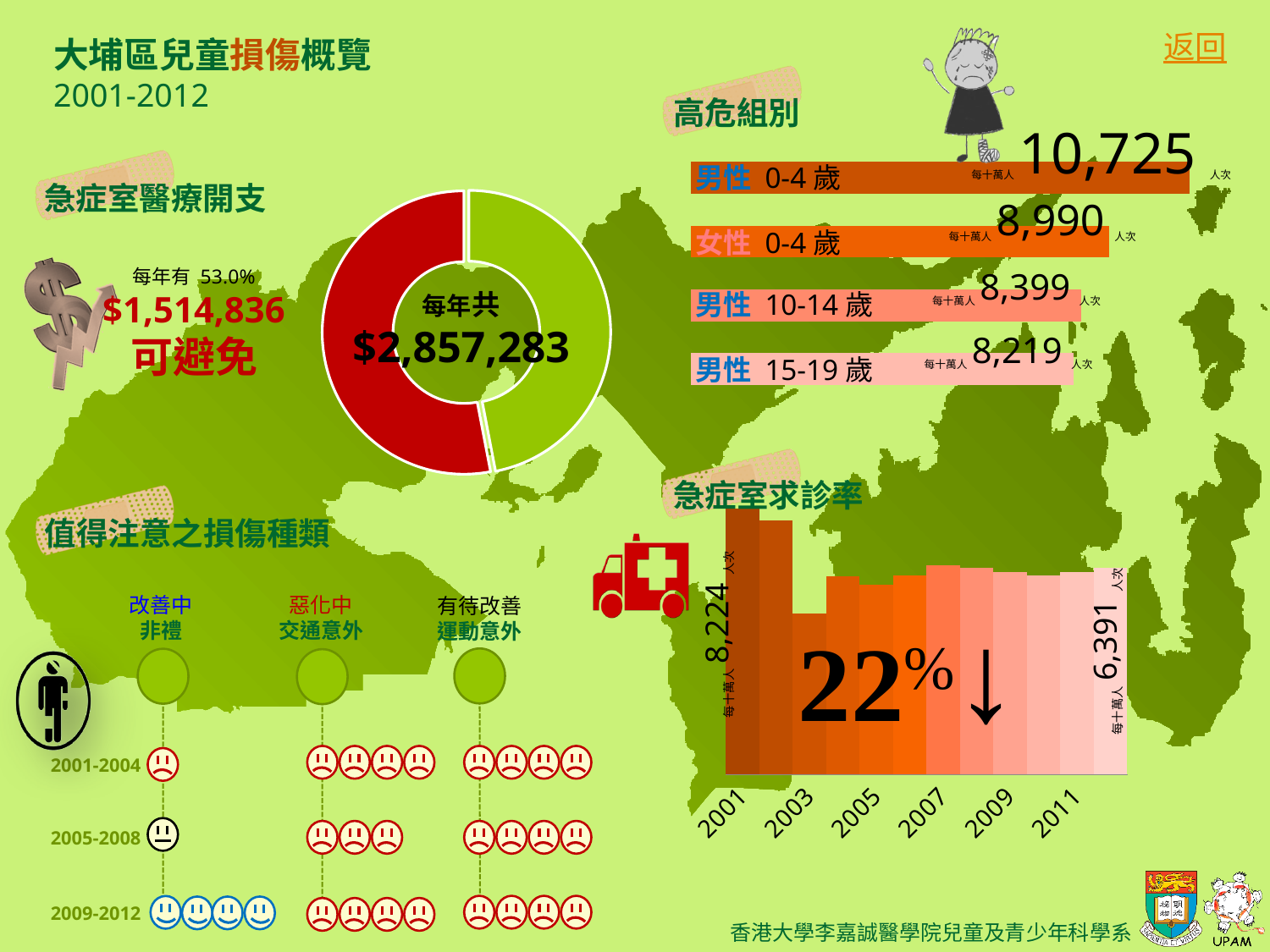
In the 急症室求診率 chart, what is the value for the last year shown (2012)? 6,391 In the 高危組別 chart, which group has the highest value? 男性 0-4 歲 In the 高危組別 chart, what is the difference between 男性 0-4 歲 and 女性 0-4 歲? 1,735 In the 急症室醫療開支 donut chart, what share of the total is marked as 可避免? 53.0% In the 高危組別 chart, which group has the lowest value? 男性 15-19 歲 How many groups are shown in the 高危組別 chart? 4 In the 急症室求診率 chart, do the values rise or fall overall from 2001 to 2012? fall In the 高危組別 chart, what is the value for 男性 15-19 歲? 8,219 What kind of chart is the 急症室求診率 chart? bar chart In the 急症室求診率 chart, what is the value for 2001? 8,224 In the 高危組別 chart, what is the value for 女性 0-4 歲? 8,990 In the 高危組別 chart, what is the value for 男性 0-4 歲? 10,725